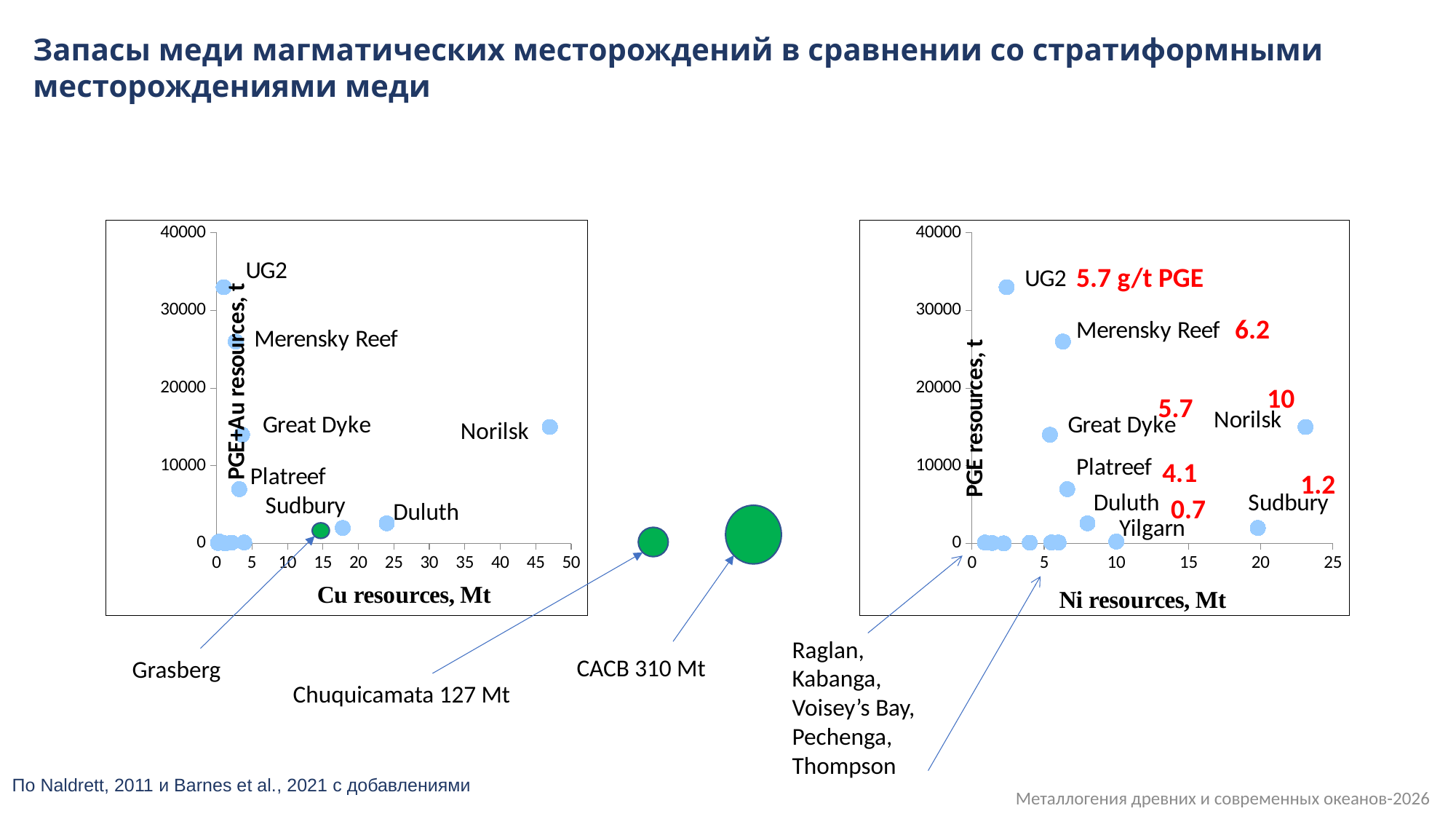
In the left chart (Cu resources, Mt), is the Cu resources value for Norilsk greater or less than 40? greater In the left chart (Cu resources, Mt), which labelled deposit has the highest PGE+Au resources? UG2 In the left chart (Cu resources, Mt), what Cu resources value is given for CACB? 310 Mt In the left chart (Cu resources, Mt), what is the difference between the Cu resources of CACB and Chuquicamata? 183 Mt In the right chart (Ni resources, Mt), what PGE grade in g/t is shown in red for Norilsk? 10 In the left chart (Cu resources, Mt), is the PGE+Au resources value for Platreef greater or less than 10000? less What kind of chart is the left chart (Cu resources, Mt)? scatter chart In the right chart (Ni resources, Mt), which has the higher red PGE grade label, Merensky Reef or UG2? Merensky Reef In the right chart (Ni resources, Mt), is the Ni resources value for Norilsk greater or less than 20? greater In the left chart (Cu resources, Mt), which labelled deposit has the largest Cu resources among the plotted points? Norilsk In the right chart (Ni resources, Mt), which deposit has the lowest red PGE grade label? Duluth